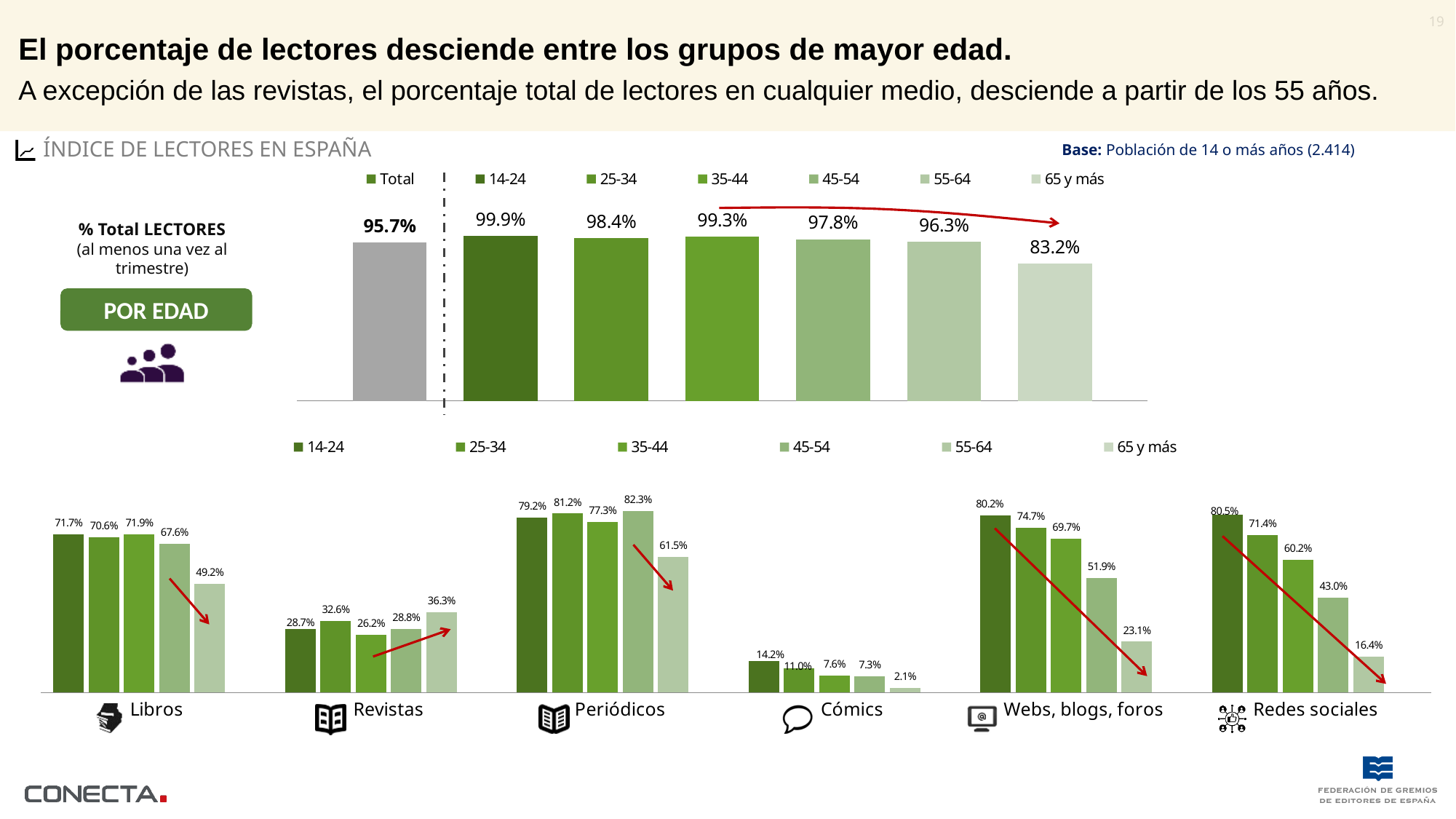
In the bottom chart by medium, what is the value of the last (lightest) bar for Redes sociales? 16.4% In the bottom chart by medium, what is the lowest value shown for Cómics? 2.1% In the top chart (% Total LECTORES por edad), what is the value for the 65 y más age group? 83.2% How many age-group series does the legend of the bottom chart list? 6 In the top chart (% Total LECTORES por edad), how many age-group bars are shown to the right of the dashed line? 6 In the top chart (% Total LECTORES por edad), what is the value of the Total bar? 95.7% In the top chart (% Total LECTORES por edad), which age group has the lowest percentage of readers? 65 y más In the top chart (% Total LECTORES por edad), what is the difference between the 55-64 value and the 65 y más value? 13.1% What kind of chart is the top chart (% Total LECTORES por edad)? Bar chart In the bottom chart by medium, what is the highest value shown for Periódicos? 82.3% In the top chart (% Total LECTORES por edad), which age group has the highest percentage of readers? 14-24 In the bottom chart by medium, which is larger: the first bar for Webs, blogs, foros or the first bar for Libros? Webs, blogs, foros